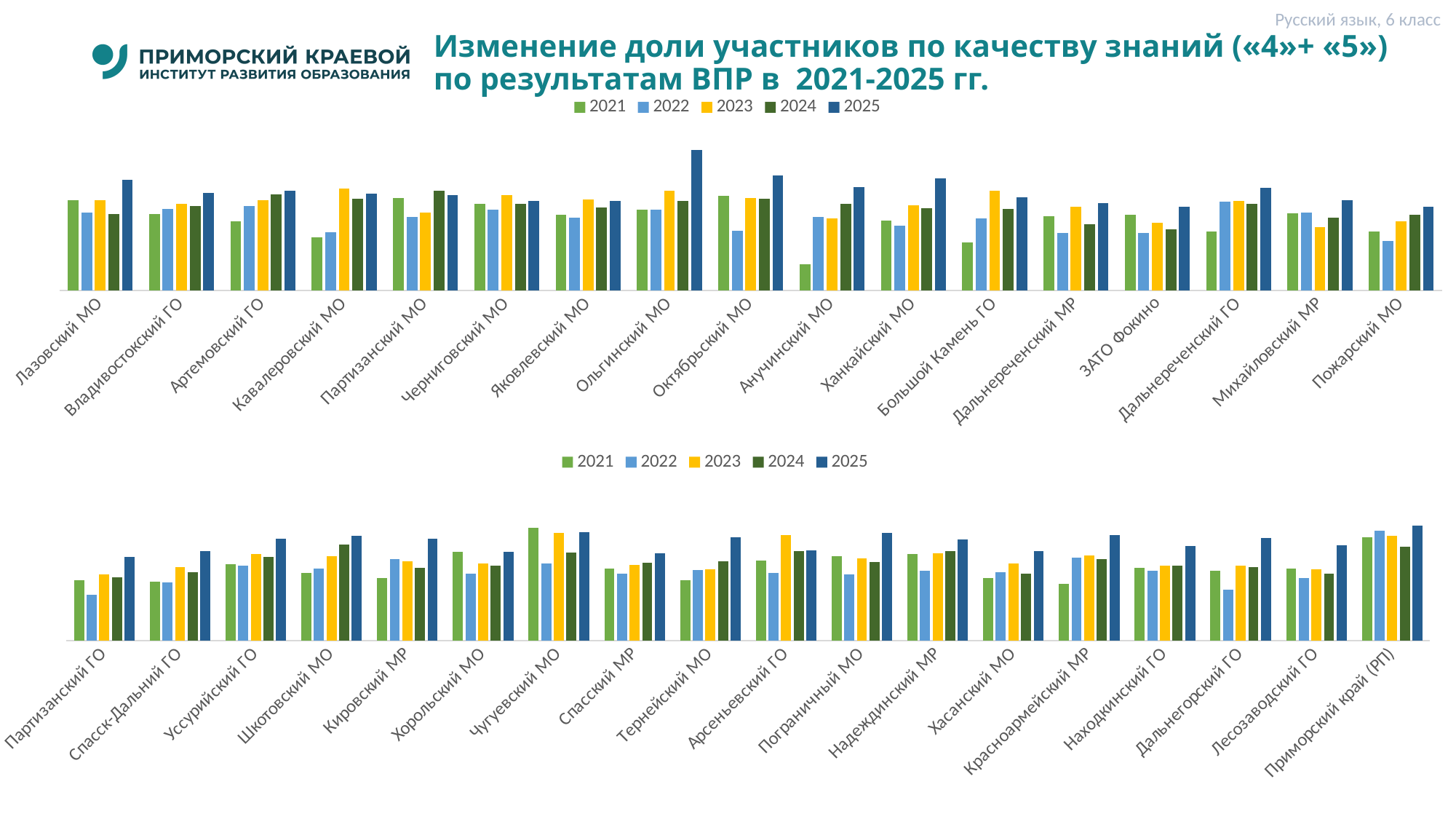
In the bottom chart, for Приморский край (РП), which is larger: the 2021 bar or the 2025 bar? 2025 Which years are listed in the legend of the bottom chart? 2021, 2022, 2023, 2024, 2025 In the top chart, which year has the lowest bar for Большой Камень ГО? 2021 What kind of chart is the top chart on the slide? bar chart In the bottom chart, which year has the lowest bar for Дальнегорский ГО? 2022 How many series does the legend of the top chart list? 5 How many categories are shown on the x axis of the bottom chart? 18 In the bottom chart, which year has the lowest bar for Партизанский ГО? 2022 In the top chart, which year has the highest bar for Анучинский МО? 2025 How many categories (municipalities) are shown on the x axis of the top chart? 17 In the top chart, which category has the tallest 2025 bar? Ольгинский МО